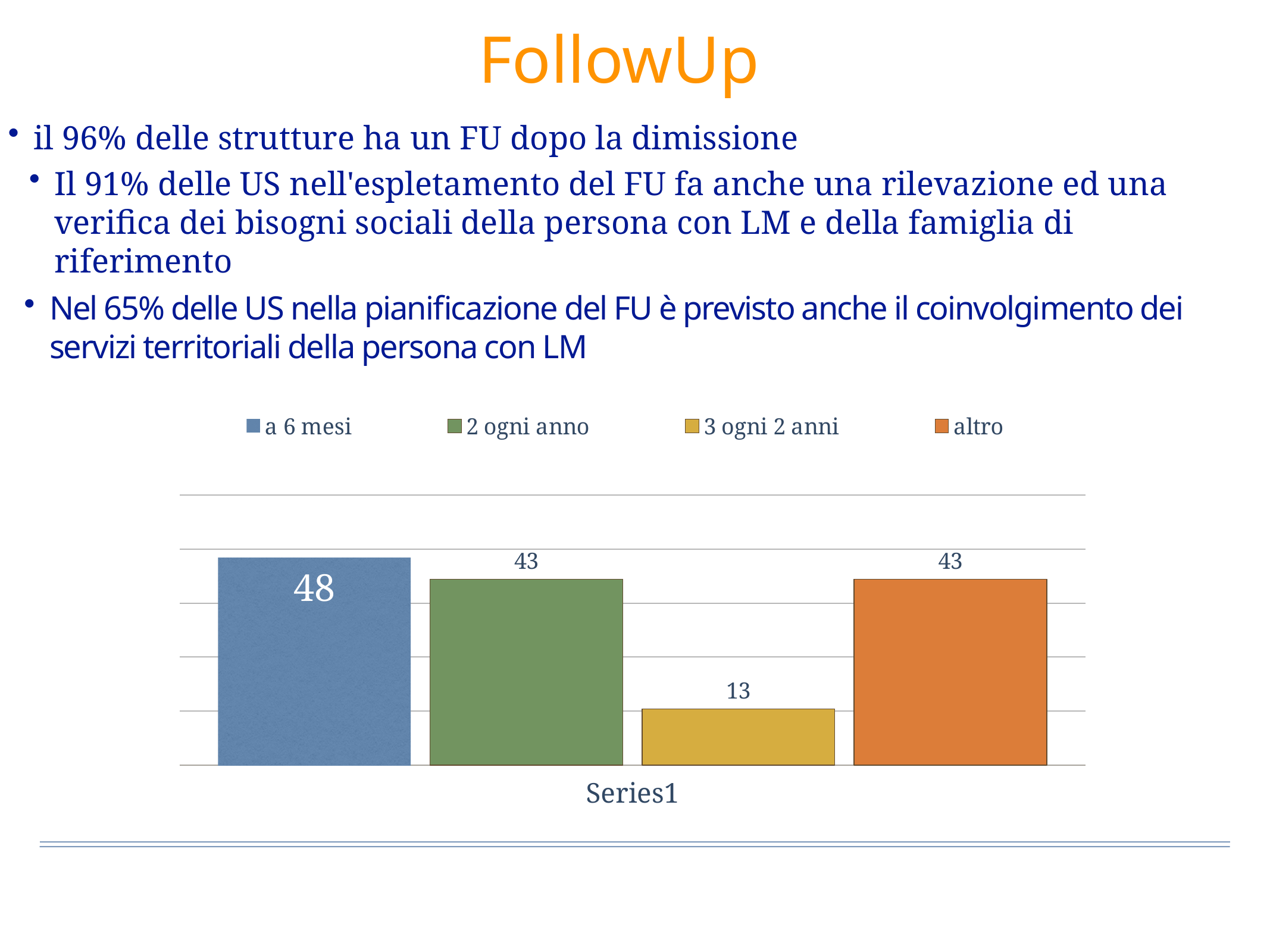
What is the difference between the values for "a 6 mesi" and "2 ogni anno"? 5 What is the difference between the values for "a 6 mesi" and "3 ogni 2 anni"? 35 What colour is the bar for "altro"? Orange What is the value for "2 ogni anno"? 43 What kind of chart is shown on the slide? Bar chart Which series has the highest value? a 6 mesi What is the value for "altro"? 43 How many series does the legend list? 4 What is the value for "a 6 mesi"? 48 What is the value for "3 ogni 2 anni"? 13 Which is larger, the value for "2 ogni anno" or the value for "3 ogni 2 anni"? 2 ogni anno Which series has the lowest value? 3 ogni 2 anni